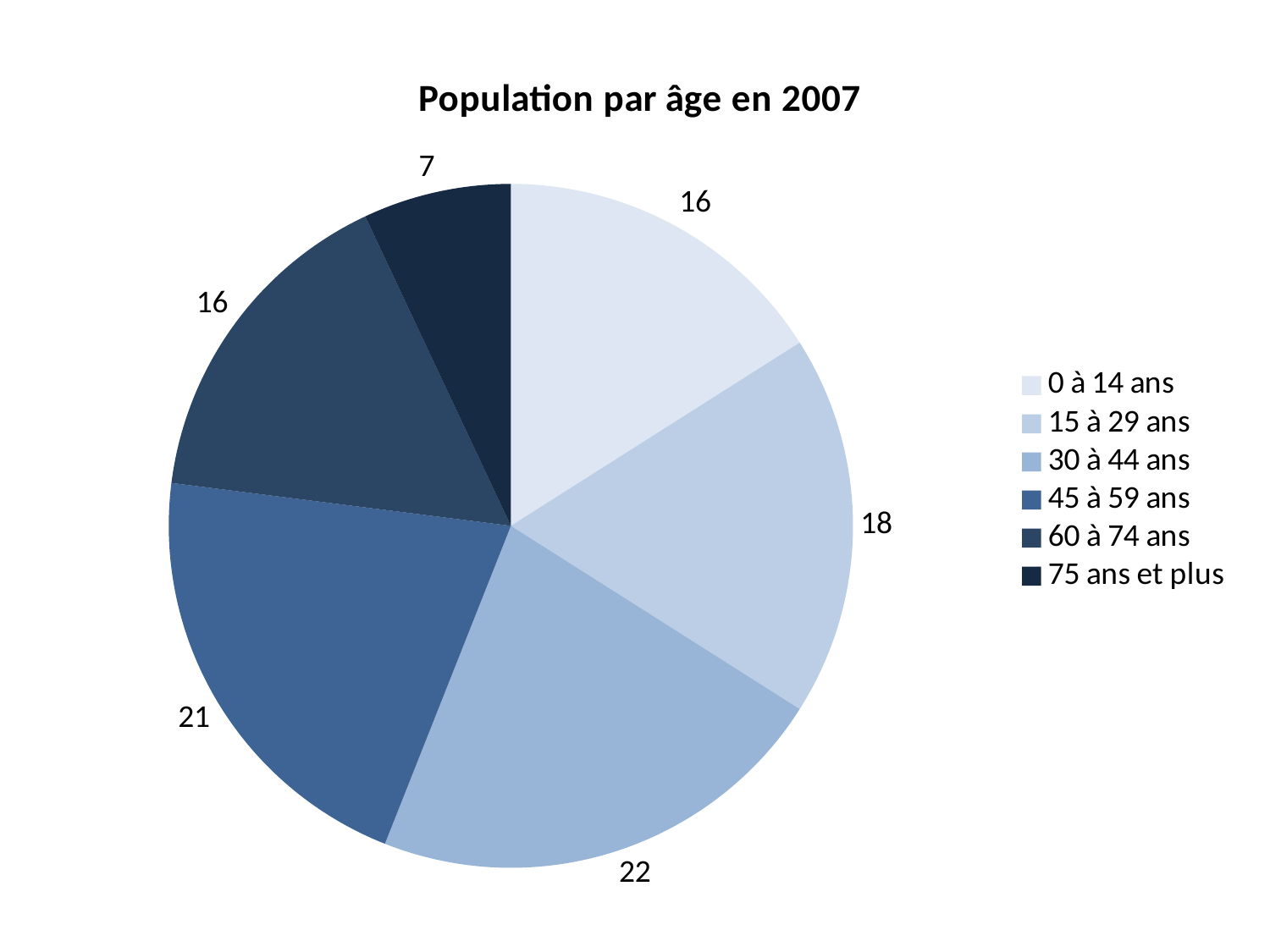
What is the title of the chart? Population par âge en 2007 What is the value for the 30 à 44 ans slice? 22 Which age group has the smallest slice? 75 ans et plus Which is larger, the value for 15 à 29 ans or the value for 60 à 74 ans? 15 à 29 ans What is the difference between the values for 45 à 59 ans and 75 ans et plus? 14 Which age group has the largest slice? 30 à 44 ans What is the value for the 75 ans et plus slice? 7 What is the value for the 15 à 29 ans slice? 18 What type of chart is shown on the slide? pie chart Which legend entry is shown with the darkest colour? 75 ans et plus How many slices does the pie chart have? 6 What share of the pie does the 45 à 59 ans slice represent? 21%